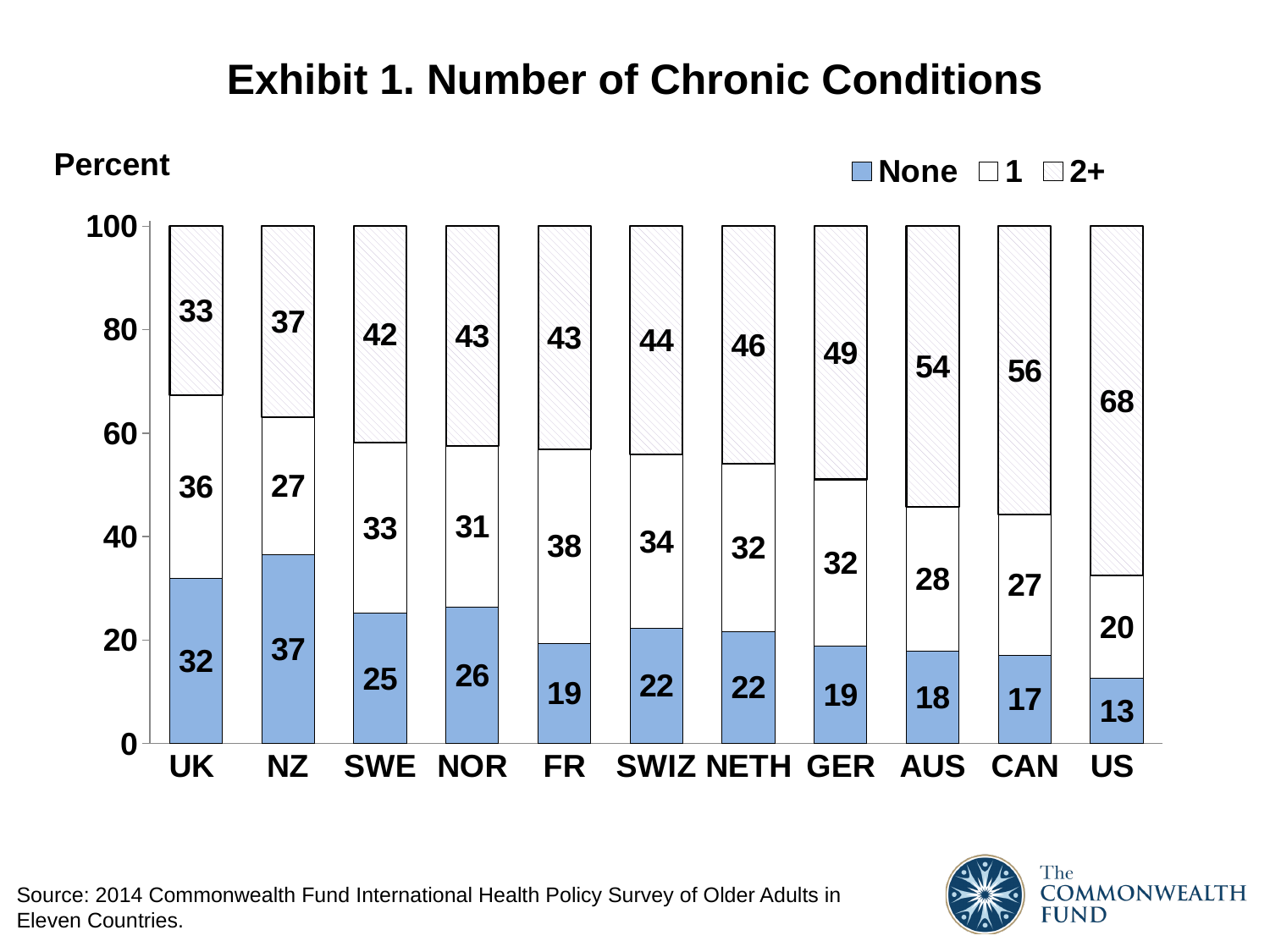
How many series does the legend list? 3 Which country has the highest value for "2+"? US What is the title of the chart? Exhibit 1. Number of Chronic Conditions What is the difference between the "2+" values for the US and the UK? 35 What is the value for "2+" for Germany (GER)? 49 What is the value for "1" for France (FR)? 38 What kind of chart is shown? Stacked bar chart Which country has the lowest value for "None"? US How many countries are shown on the x axis? 11 What is the value for "None" for the US? 13 Which country has the highest value for "None"? NZ Which is larger, the "1" value for the UK or the "1" value for NZ? UK